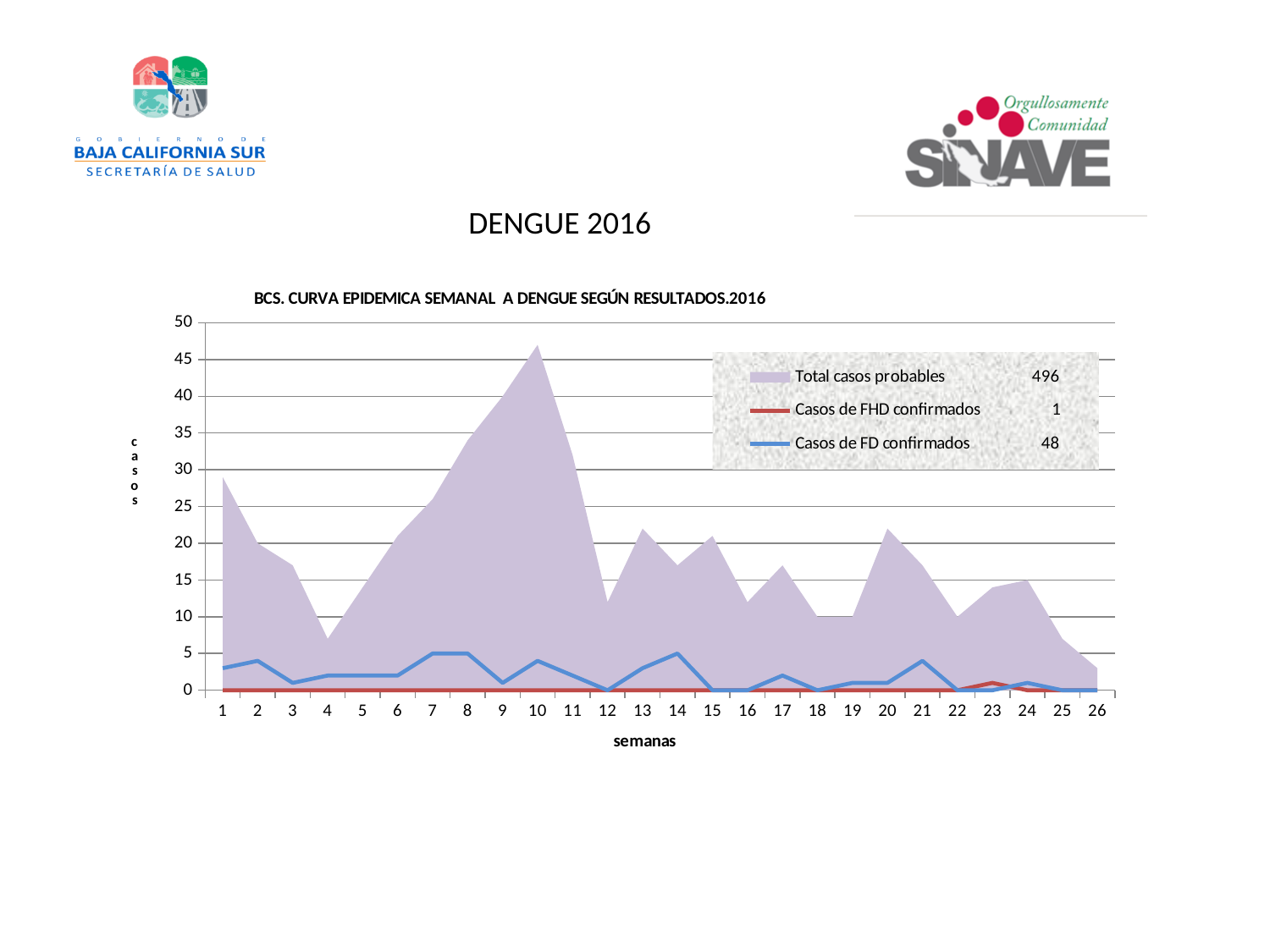
Is the value of Total casos probables in week 10 greater or less than 40? greater Is the value of Total casos probables in week 1 greater or less than 25? greater In which week do the Total casos probables reach their highest value? 10 Which week has more Total casos probables, week 10 or week 13? week 10 What kind of chart is shown on the slide? combination area and line chart Do the Total casos probables rise or fall from week 10 to week 12? fall What total is shown in the legend for Casos de FD confirmados? 48 Which week has more Total casos probables, week 18 or week 20? week 20 How many series does the chart legend list? 3 Is the value of Total casos probables in week 4 greater or less than 10? less How many weeks (semanas) are shown on the x axis of the chart? 26 What total is shown in the legend for Total casos probables? 496